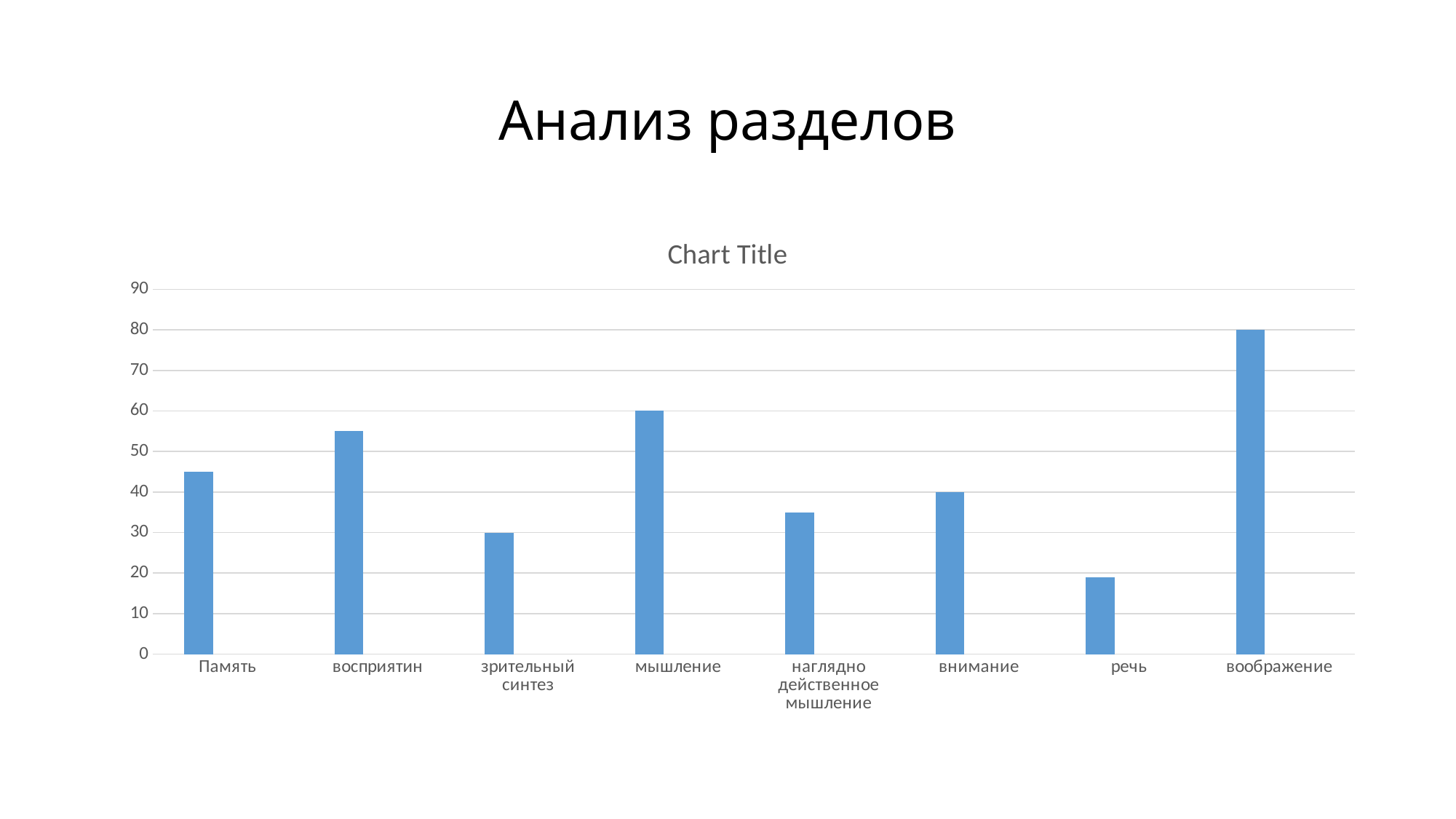
What kind of chart is shown on the slide? bar chart Which is larger, the value for восприятин or the value for наглядно действенное мышление? восприятин What is the value for воображение? 80 Which category has the highest bar in the chart? воображение What is the title shown above the chart? Chart Title Which category has the lowest bar in the chart? речь How many categories are shown on the x axis of the chart? 8 What is the value for внимание? 40 What is the value for мышление? 60 What is the value for зрительный синтез? 30 Is the value for Память greater or less than 40? greater